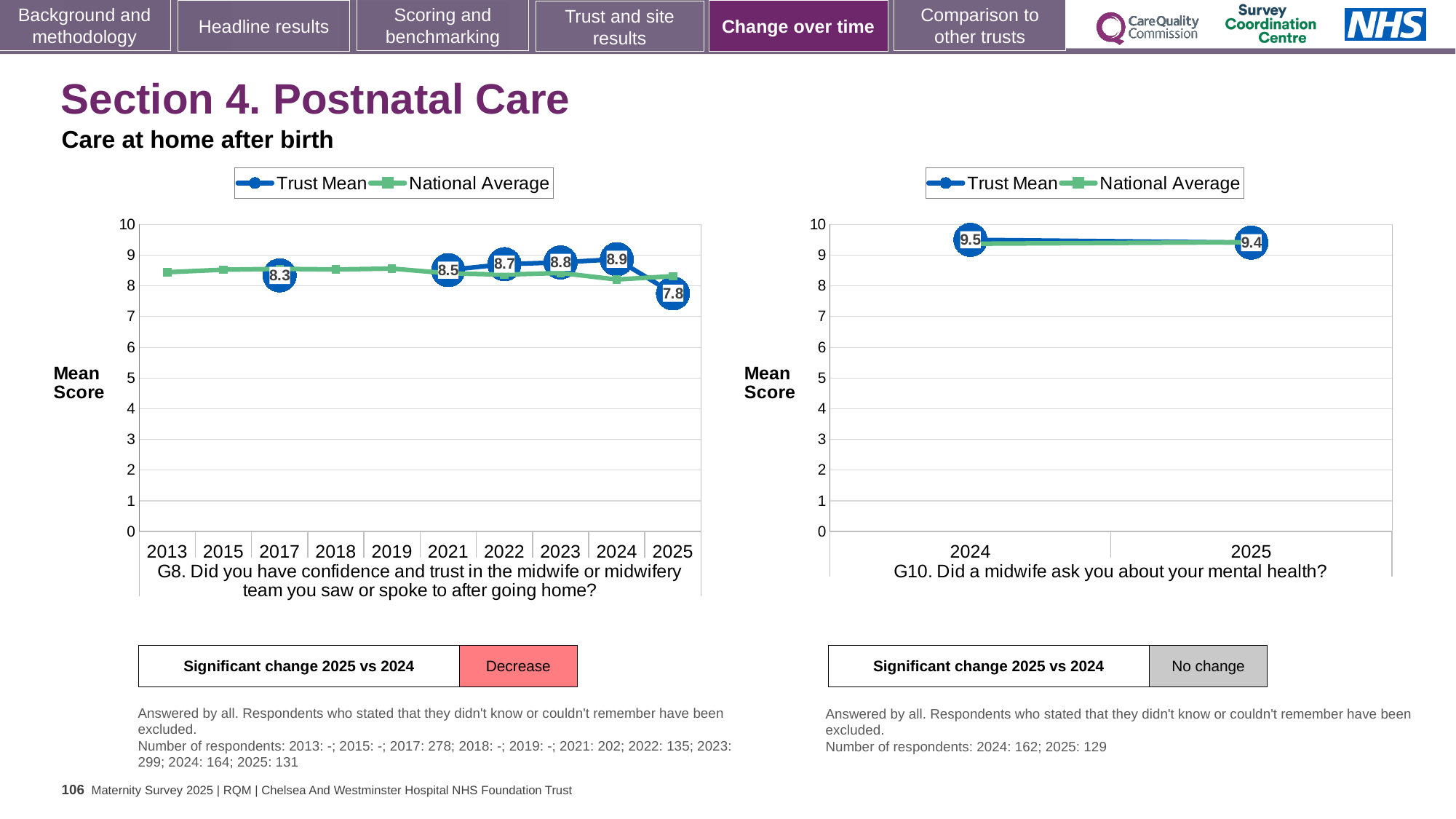
In the G8 chart on the left, what is the Trust Mean score for 2017? 8.3 In the G8 chart on the left, which year has the lowest labelled Trust Mean score? 2025 In the G10 chart on the right, what is the Trust Mean score for 2025? 9.4 In the G8 chart on the left, is the National Average value for 2013 greater or less than 7? greater In the G10 chart on the right, what is the difference between the Trust Mean scores for 2024 and 2025? 0.1 In the G8 chart on the left, what is the Trust Mean score for 2024? 8.9 In the G8 chart on the left, what is the difference between the Trust Mean scores for 2024 and 2025? 1.1 In the G8 chart on the left, what is the Trust Mean score for 2025? 7.8 How many years are shown on the x axis of the G8 chart on the left? 10 In the G8 chart on the left, is the Trust Mean score for 2022 larger or smaller than the score for 2021? larger How many series does the legend of the G10 chart on the right list? 2 In the G8 chart on the left, which year has the highest Trust Mean score? 2024